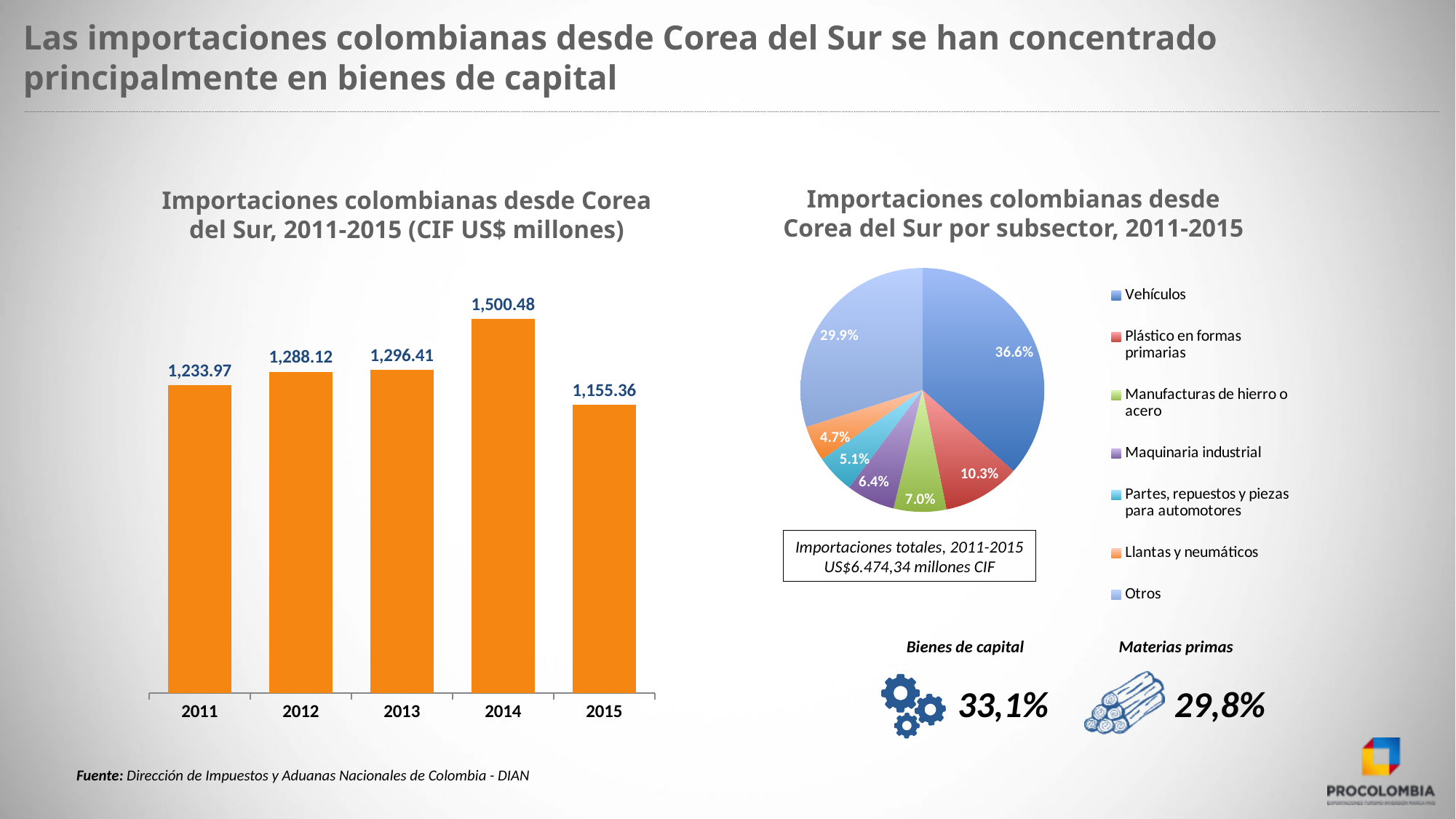
In the bar chart on the left, what was the value of Colombian imports from South Korea in 2014? 1,500.48 In the bar chart on the left, how many years are shown? 5 In the bar chart on the left, which year had the lowest imports? 2015 In the bar chart on the left, which year had larger imports, 2012 or 2015? 2012 In the pie chart on the right, what share do Llantas y neumáticos represent? 4.7% What type of chart is the chart on the left? Bar chart How many categories does the legend of the pie chart on the right list? 7 In the bar chart on the left, which year had the highest imports? 2014 In the pie chart on the right, which subsector has the smallest share? Llantas y neumáticos In the bar chart on the left, what is the difference between the 2014 and 2015 values? 345.12 In the pie chart on the right, what share do Vehículos represent? 36.6% In the bar chart on the left, what was the value of imports in 2011? 1,233.97